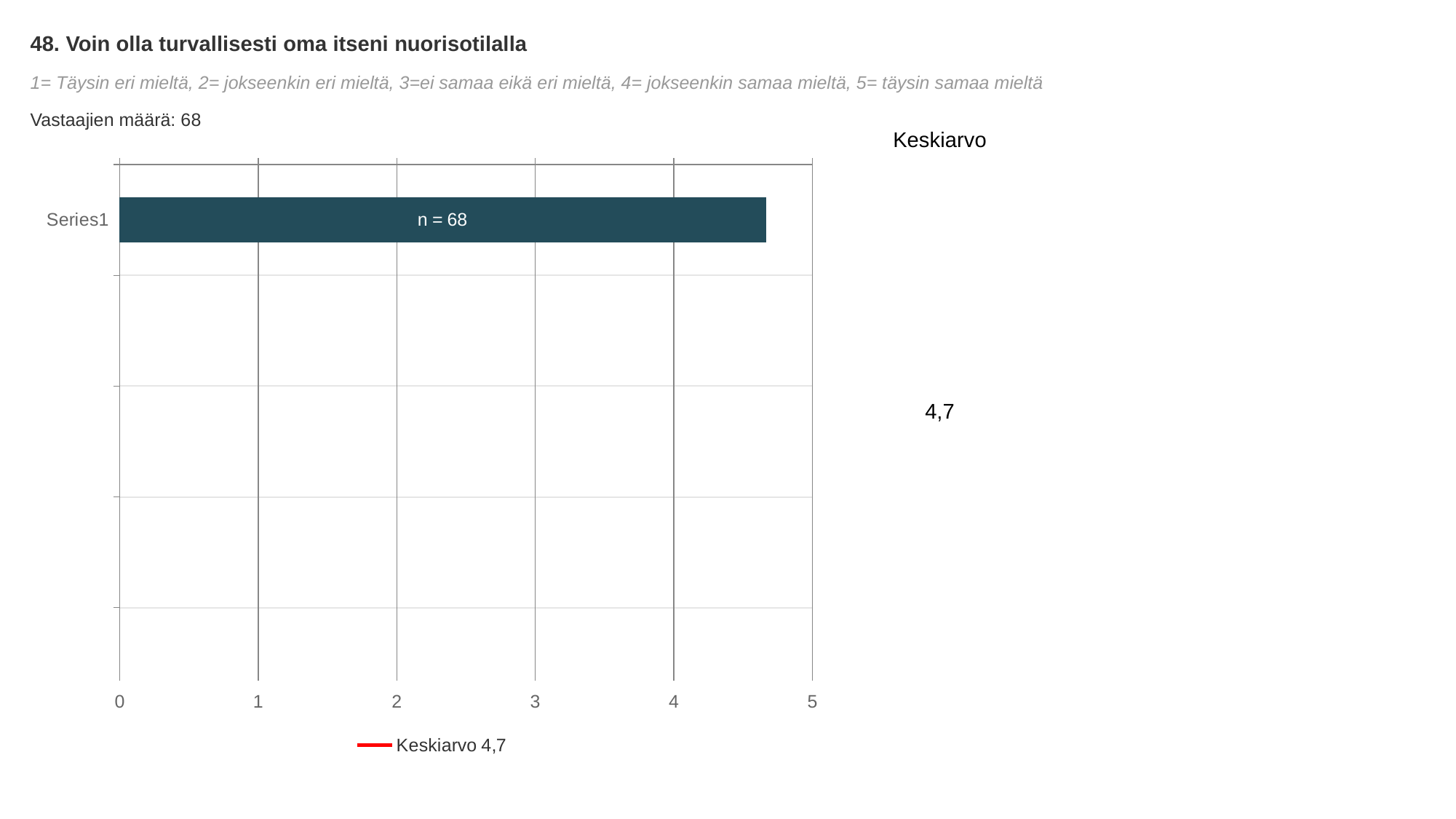
What kind of chart is shown on the slide? bar chart How many respondents (Vastaajien määrä) are reported on the slide? 68 Is the value of the Series1 bar greater or less than 4? greater What text does the legend entry below the chart show? Keskiarvo 4,7 Is the value of the Series1 bar greater or less than 3? greater What data label is printed on the Series1 bar? n = 68 How many bars are plotted in the chart? 1 What is the Keskiarvo (mean) value shown on the slide? 4,7 What is the highest value shown on the horizontal axis? 5 What is the label of the category on the vertical axis? Series1 Is the value of the Series1 bar greater or less than 5? less